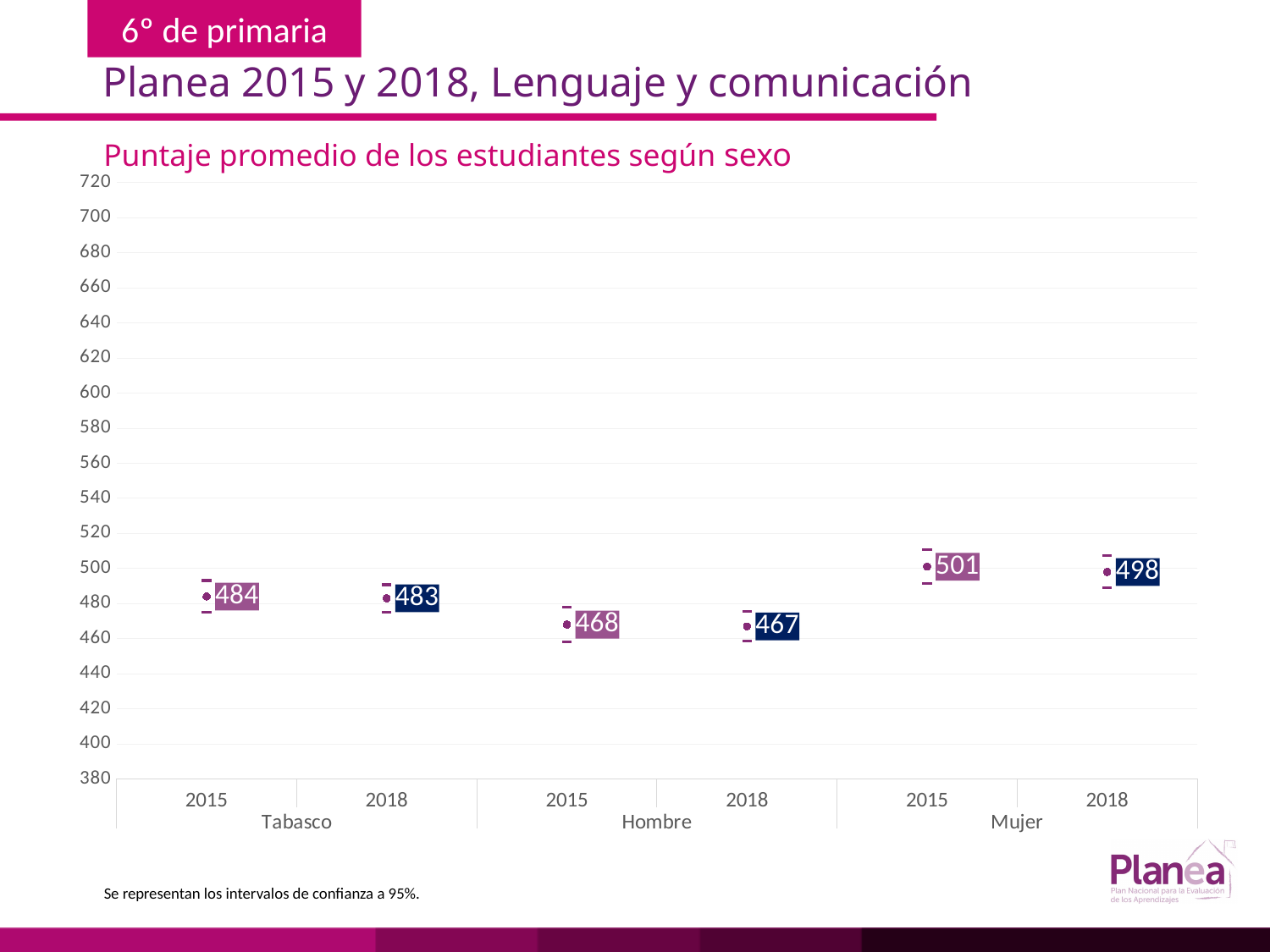
What is the average score for Hombre in 2018? 467 Which is larger, the Mujer score in 2018 or the Tabasco score in 2018? Mujer 2018 How many data points are plotted on the chart? 6 What is the difference between the Tabasco score in 2015 and in 2018? 1 What is the average score for Mujer in 2015? 501 Which group and year has the lowest average score? Hombre 2018 Is the value for Hombre in 2015 greater or less than 480? less What is the title of the chart? Puntaje promedio de los estudiantes según sexo What is the difference between the Mujer score in 2015 and the Hombre score in 2015? 33 What is the average score for Tabasco in 2015? 484 Which group and year has the highest average score? Mujer 2015 What is the average score for Mujer in 2018? 498